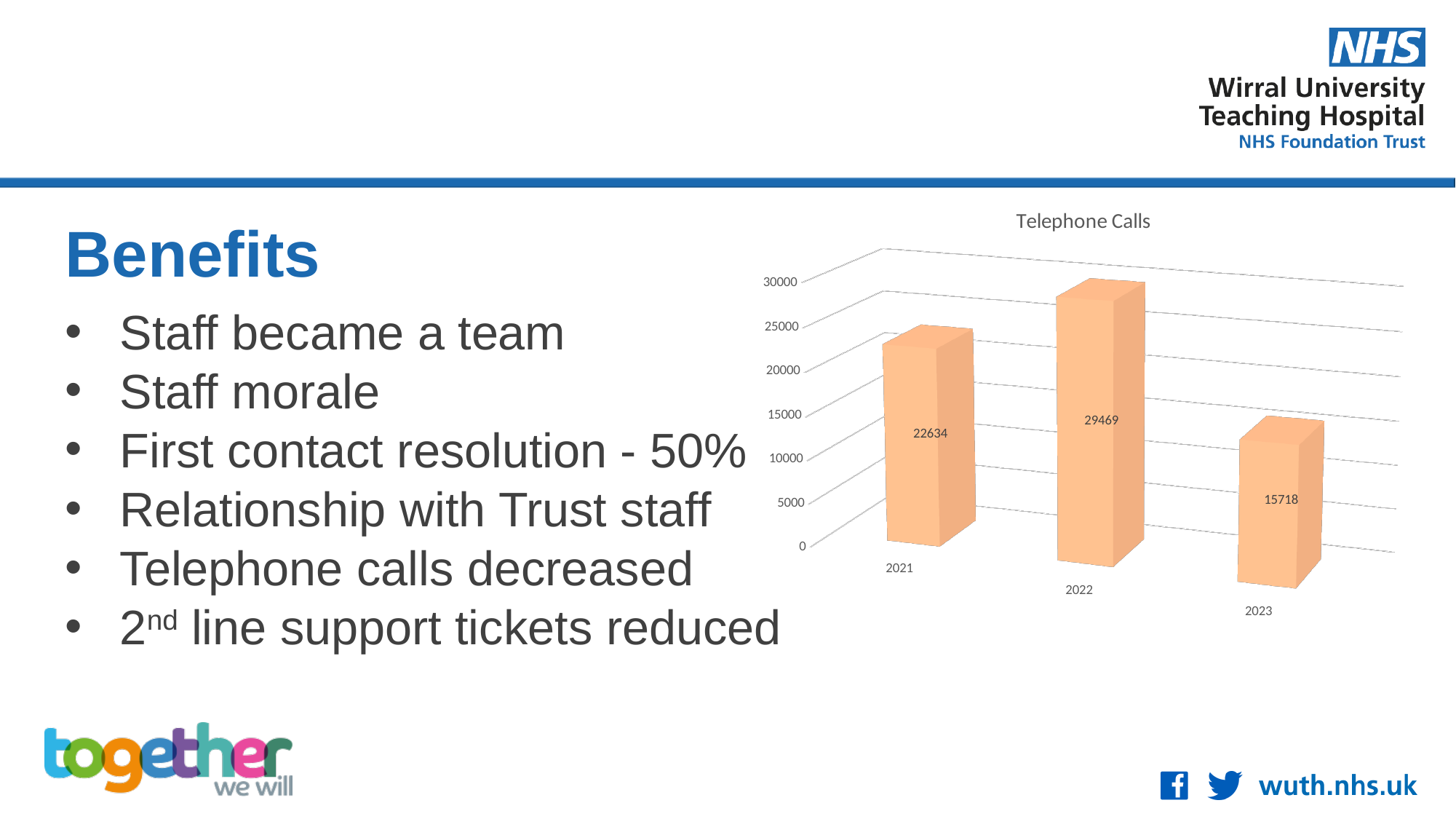
Which year has the highest number of telephone calls? 2022 How many years are shown in the Telephone Calls chart? 3 Which year had more telephone calls, 2021 or 2023? 2021 What is the value for 2021 in the Telephone Calls chart? 22634 What is the difference between the telephone calls in 2022 and 2023? 13751 What is the value for 2023 in the Telephone Calls chart? 15718 Is the value for 2023 greater or less than 20000? less What is the title of the chart on the slide? Telephone Calls What kind of chart is used to show the telephone calls? bar chart Which year has the lowest number of telephone calls? 2023 What is the value for 2022 in the Telephone Calls chart? 29469 What is the difference between the telephone calls in 2022 and 2021? 6835